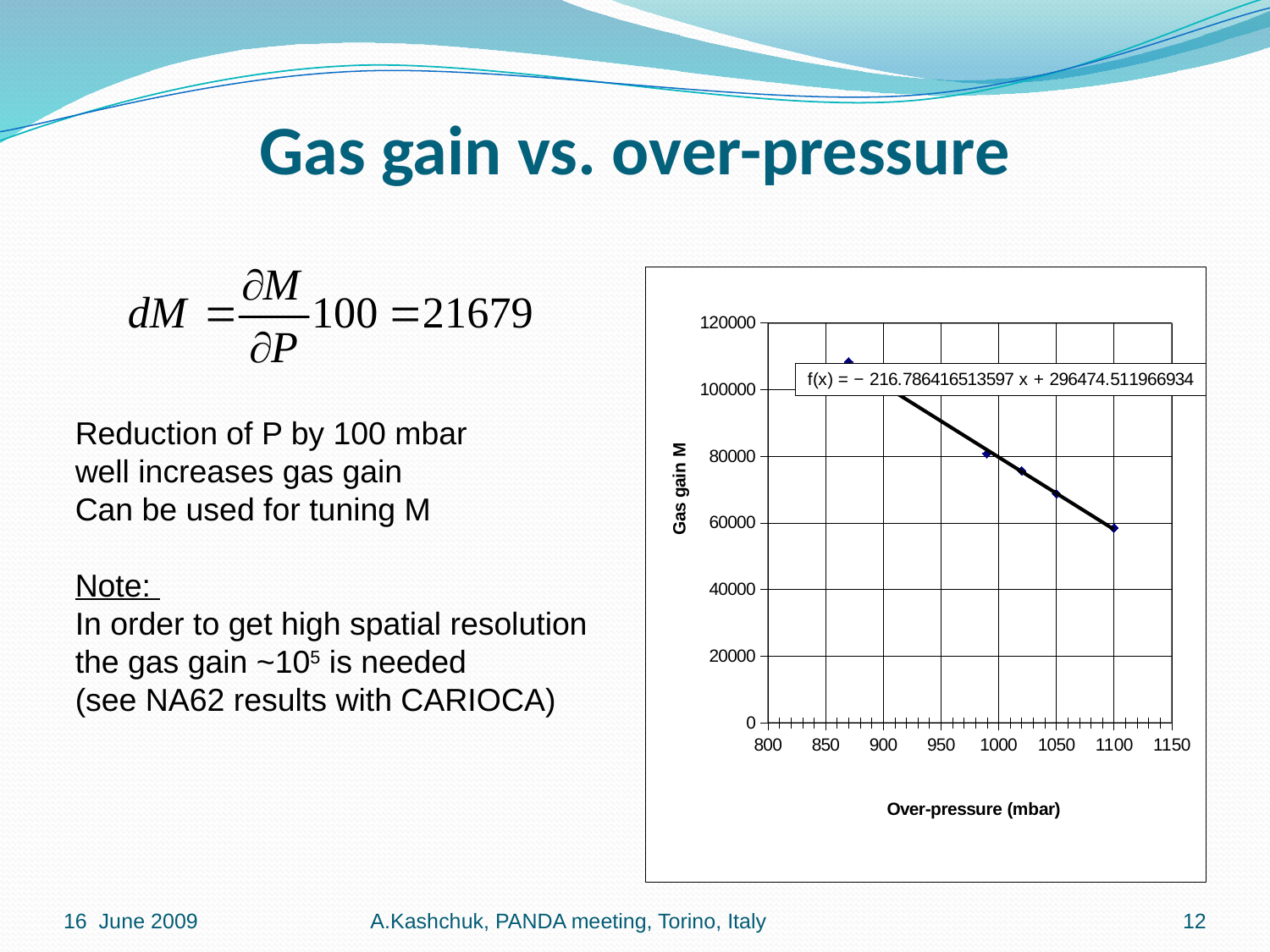
What is the label of the x axis of the chart? Over-pressure (mbar) What is the slope of the fitted line f(x) shown in the chart? − 216.786416513597 What is the maximum value shown on the y axis of the chart? 120000 Does the gas gain M rise or fall as over-pressure increases along the x axis? fall Is the gas gain M at the point near 1050 mbar greater or less than 60000? greater Is the gas gain M at the lowest over-pressure point (around 870 mbar) greater or less than 100000? greater What kind of chart is shown on the slide? scatter chart How many data points are plotted in the chart? 5 Which has the higher gas gain M: the point near 870 mbar or the point near 1100 mbar? the point near 870 mbar Is the gas gain M at the point near 990 mbar greater or less than 100000? less What is the label of the y axis of the chart? Gas gain M